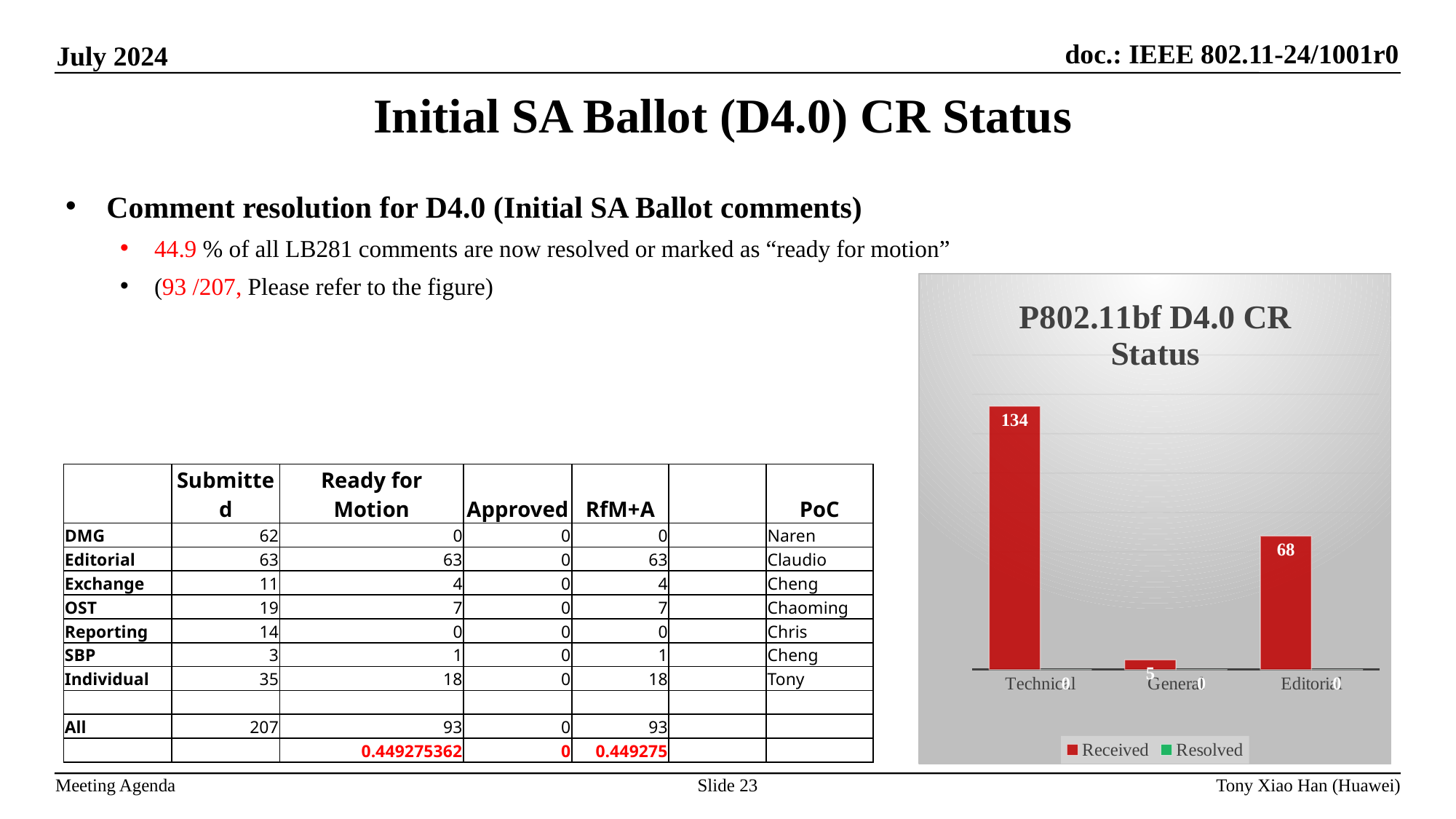
What type of chart is shown on the slide? bar chart How many categories are shown on the x axis of the chart? 3 Which is larger in the chart, the Received value for Editorial or for General? Editorial What is the Received value for General in the chart? 5 What is the title of the chart on the slide? P802.11bf D4.0 CR Status Which category has the highest Received value in the chart? Technical How many series does the chart legend list? 2 What is the Received value for Editorial in the chart? 68 Which category has the lowest Received value in the chart? General What is the Received value for Technical in the chart? 134 What is the difference between the Received values for Technical and Editorial in the chart? 66 Which series are listed in the chart legend? Received, Resolved